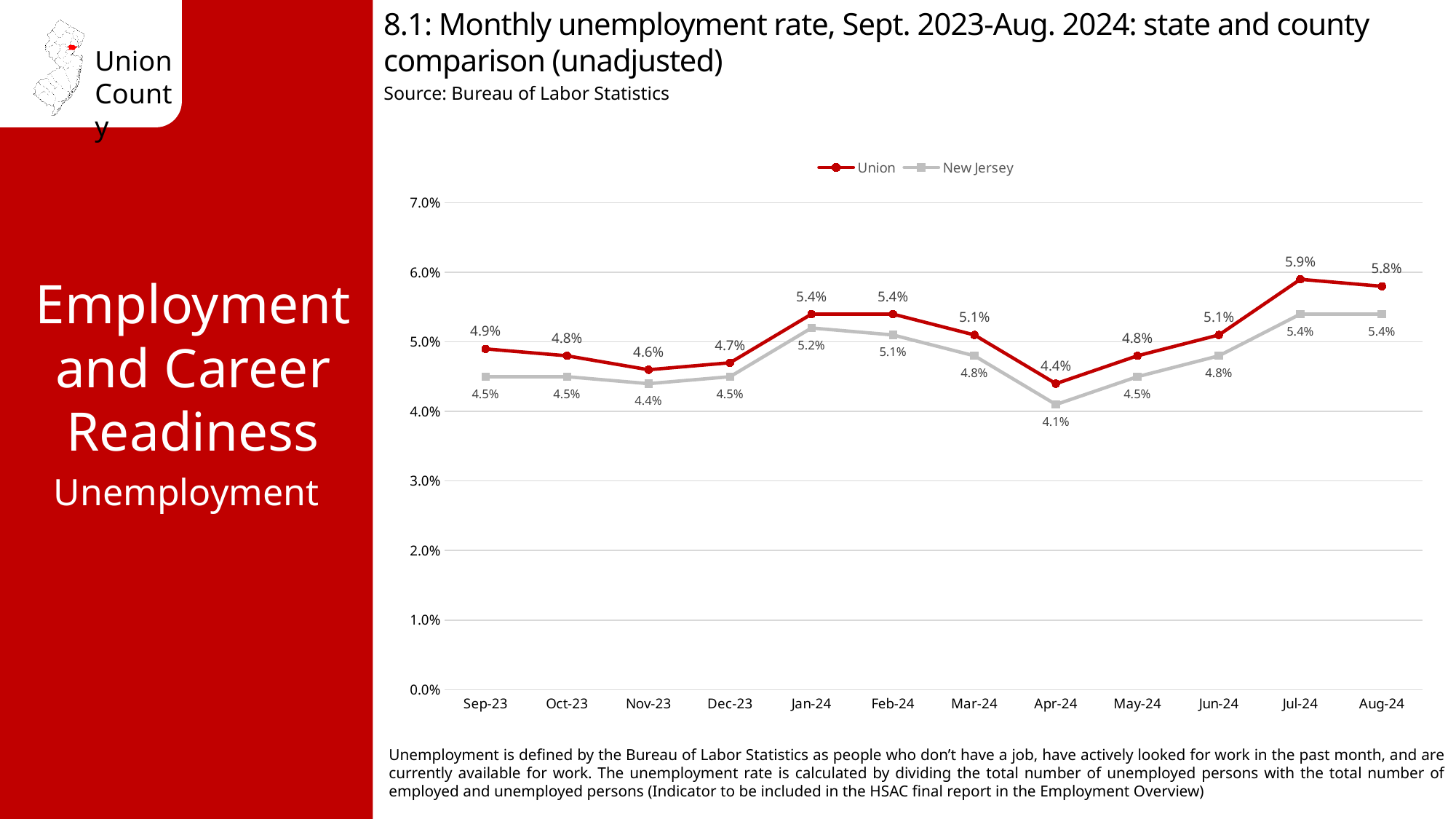
Did the Union unemployment rate rise or fall from Apr-24 to Jul-24? Rise What was the unemployment rate for Union in Nov-23? 4.6% How many months are shown on the x axis? 12 In which month was the Union unemployment rate highest? Jul-24 Which series had the higher unemployment rate in Jan-24, Union or New Jersey? Union What is the source cited for the chart? Bureau of Labor Statistics What was the unemployment rate for New Jersey in Apr-24? 4.1% What kind of chart is shown on the slide? Line chart What was the unemployment rate for Union in Jul-24? 5.9% How many series does the legend list? 2 What is the difference between the Union and New Jersey unemployment rates in Jul-24? 0.5% In which month was the New Jersey unemployment rate lowest? Apr-24